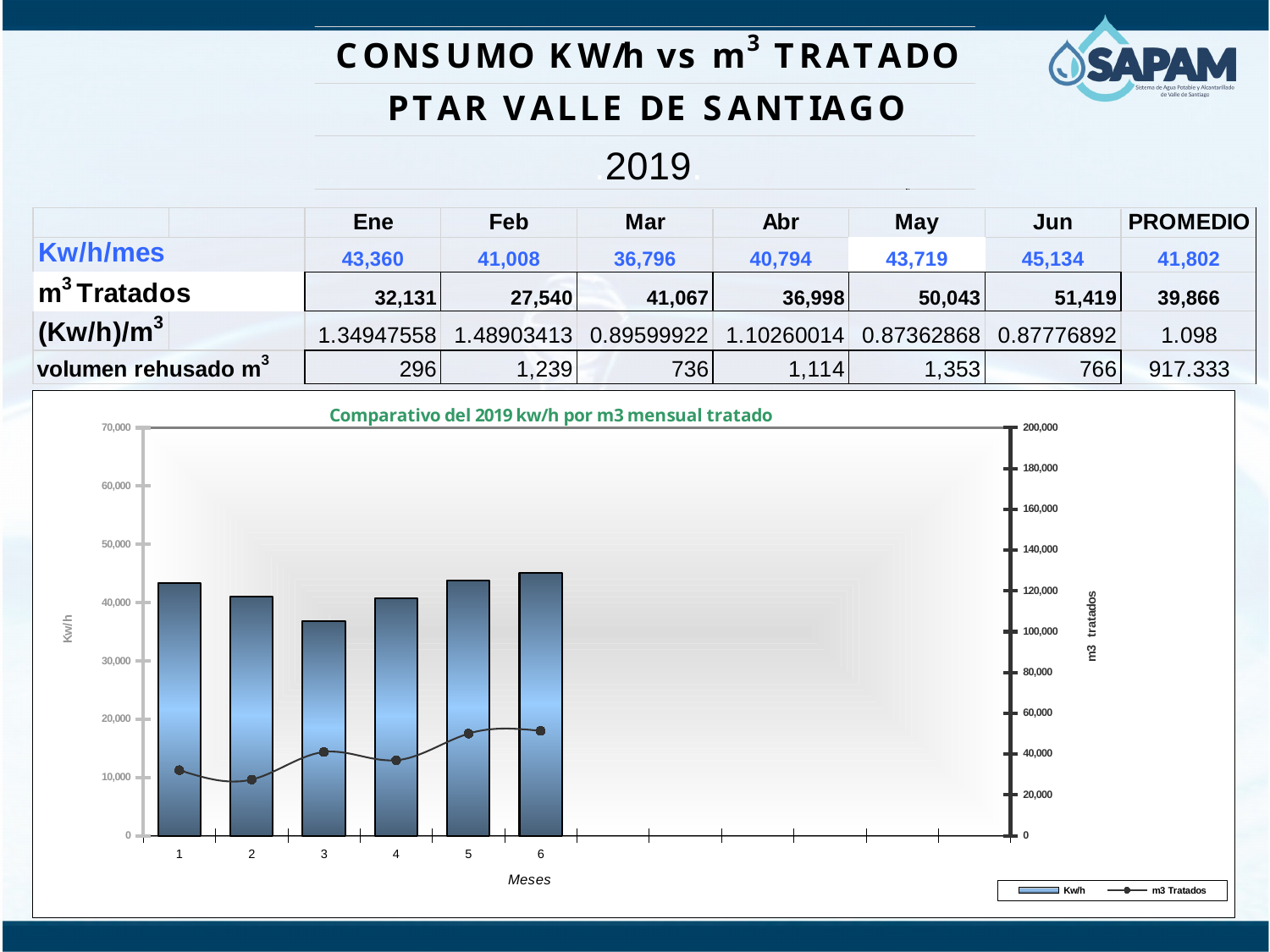
What is the Kw/h value for month 3 (Mar)? 36,796 Is the Kw/h bar for month 3 greater or less than 40,000? less Which month has the lowest m3 Tratados value on the line? 2 (Feb) What is the difference between the Kw/h values for Jun and Mar? 8,338 Does the m3 Tratados line rise or fall overall from month 1 to month 6? rises What kind of chart is shown on the slide? A bar chart combined with a line Which month has the highest Kw/h bar? 6 (Jun) Which month has the lowest Kw/h bar? 3 (Mar) How many months are plotted on the chart's x axis? 6 How many series does the chart legend list? 2 What is the m3 Tratados value for month 6 (Jun)? 51,419 What is the title of the chart? Comparativo del 2019 kw/h por m3 mensual tratado